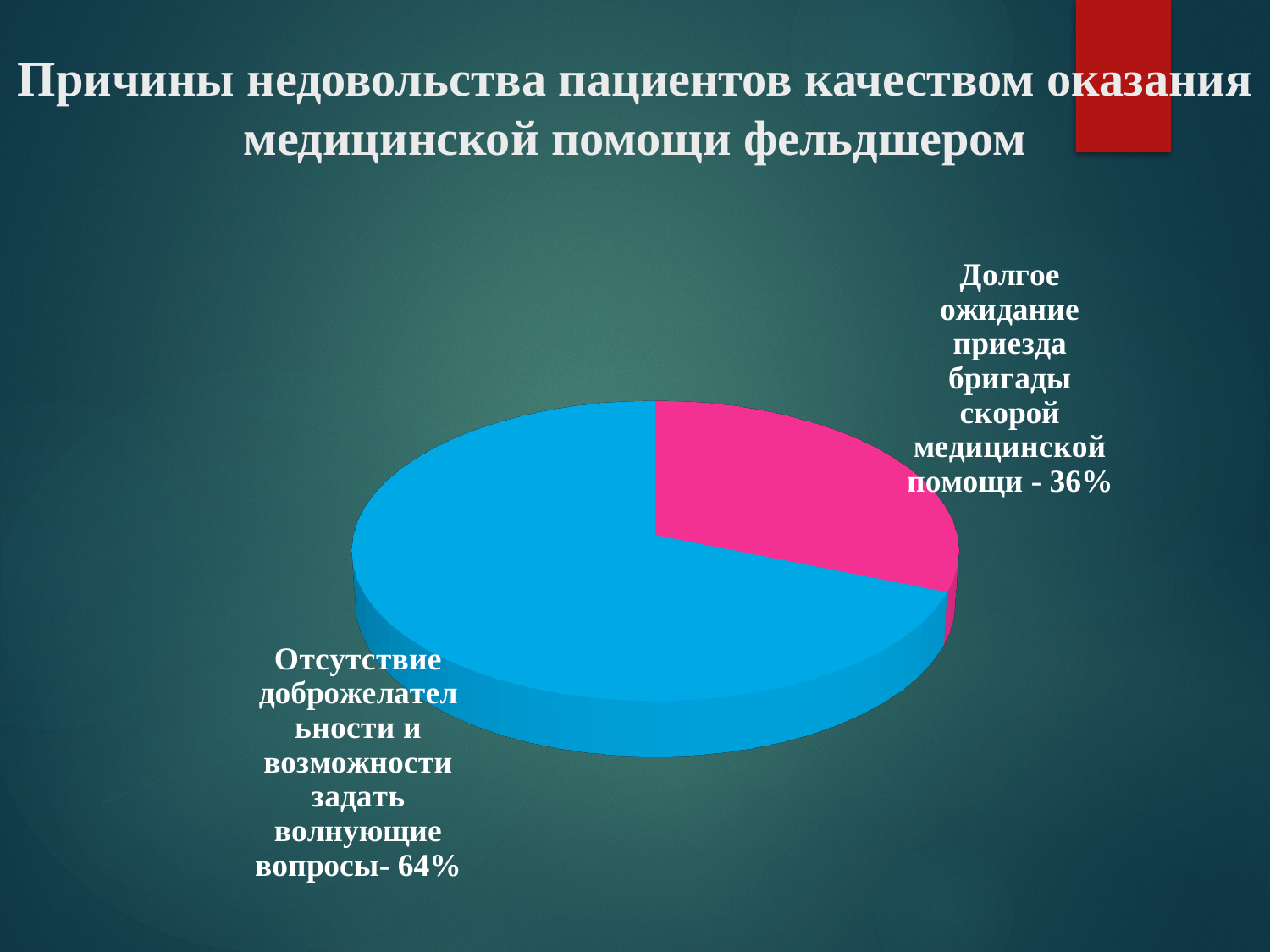
Which is larger: the share for "Долгое ожидание приезда бригады скорой медицинской помощи" or the share for "Отсутствие доброжелательности и возможности задать волнующие вопросы"? Отсутствие доброжелательности и возможности задать волнующие вопросы Which category has the largest share of the pie? Отсутствие доброжелательности и возможности задать волнующие вопросы What kind of chart is shown on the slide? pie chart What colour is the slice representing 36%? pink What is the difference in percentage points between the two slices of the pie? 28 Which category has the smallest share of the pie? Долгое ожидание приезда бригады скорой медицинской помощи What is the total of the two slices shown in the pie chart? 100% How many slices does the pie chart have? 2 What colour is the slice representing 64%? blue What share of the pie is labelled "Отсутствие доброжелательности и возможности задать волнующие вопросы"? 64% What share of the pie is labelled "Долгое ожидание приезда бригады скорой медицинской помощи"? 36%